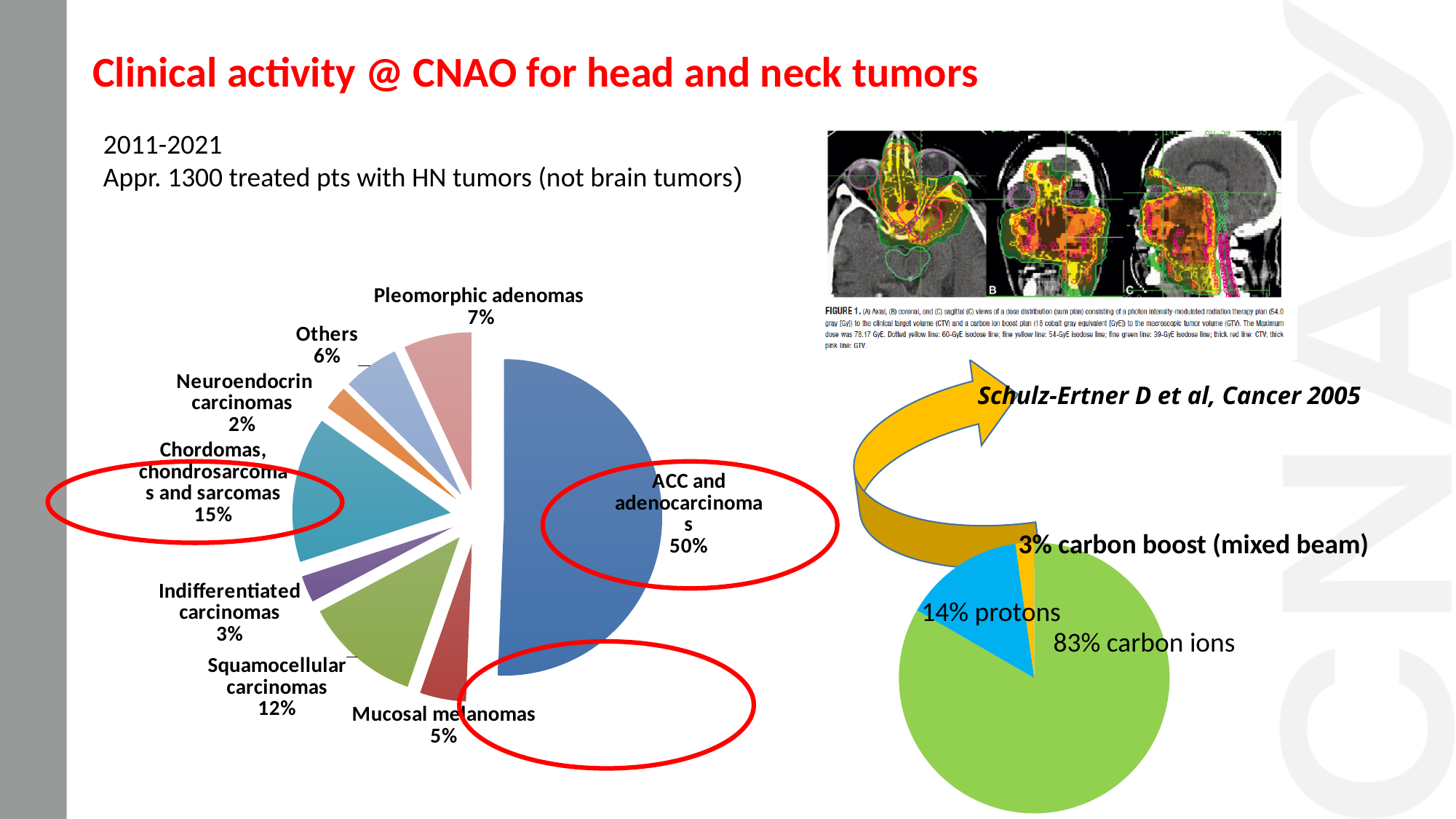
How many slices does the right pie chart of treatment modalities have? 3 In the left pie chart of tumor types, which category has the largest share? ACC and adenocarcinomas In the left pie chart of tumor types, what is the difference between the shares of Pleomorphic adenomas and Mucosal melanomas? 2% What type of chart is used on the left to show the distribution of tumor types? Pie chart In the left pie chart of tumor types, which category has the smallest share? Neuroendocrin carcinomas In the left pie chart of tumor types, what share is Squamocellular carcinomas? 12% In the right pie chart of treatment modalities, what share is carbon ions? 83% In the right pie chart of treatment modalities, what share is carbon boost (mixed beam)? 3% How many categories are shown in the left pie chart of tumor types? 8 In the left pie chart of tumor types, what share is Chordomas, chondrosarcomas and sarcomas? 15% In the left pie chart of tumor types, which is larger: Others or Indifferentiated carcinomas? Others In the left pie chart of tumor types, what share is ACC and adenocarcinomas? 50%